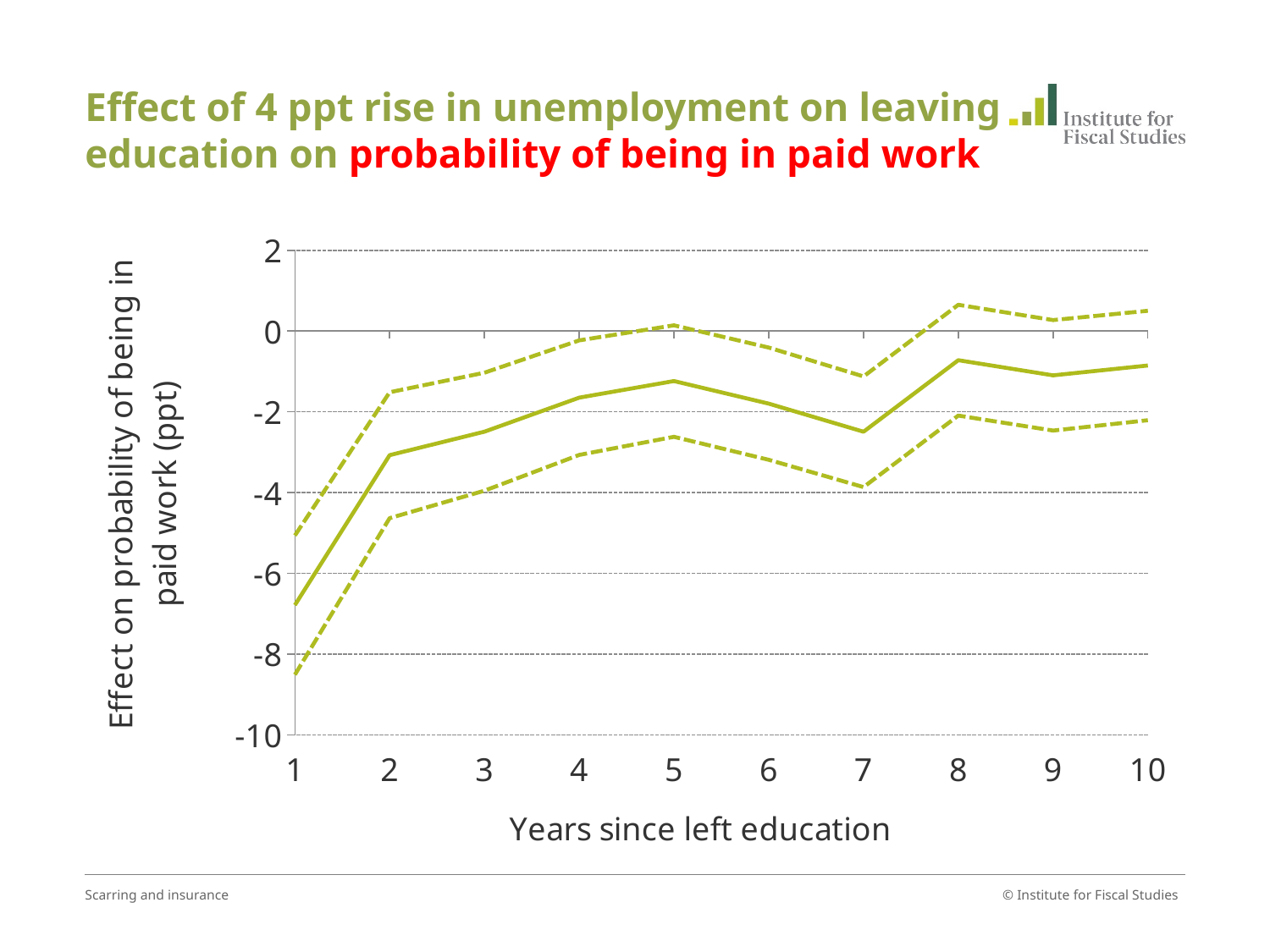
What kind of chart is shown on the slide? line chart Is the value of the upper dashed line at year 8 greater or less than 0? greater At which year since leaving education is the solid line at its lowest value? 1 Is the value of the solid line at year 8 greater or less than 0? less Does the solid line rise or fall between year 1 and year 5? rise Is the value of the lower dashed line at year 1 greater or less than -8? less What is the title of the y axis? Effect on probability of being in paid work (ppt) How many years since leaving education are plotted along the x axis? 10 What is the title of the x axis? Years since left education